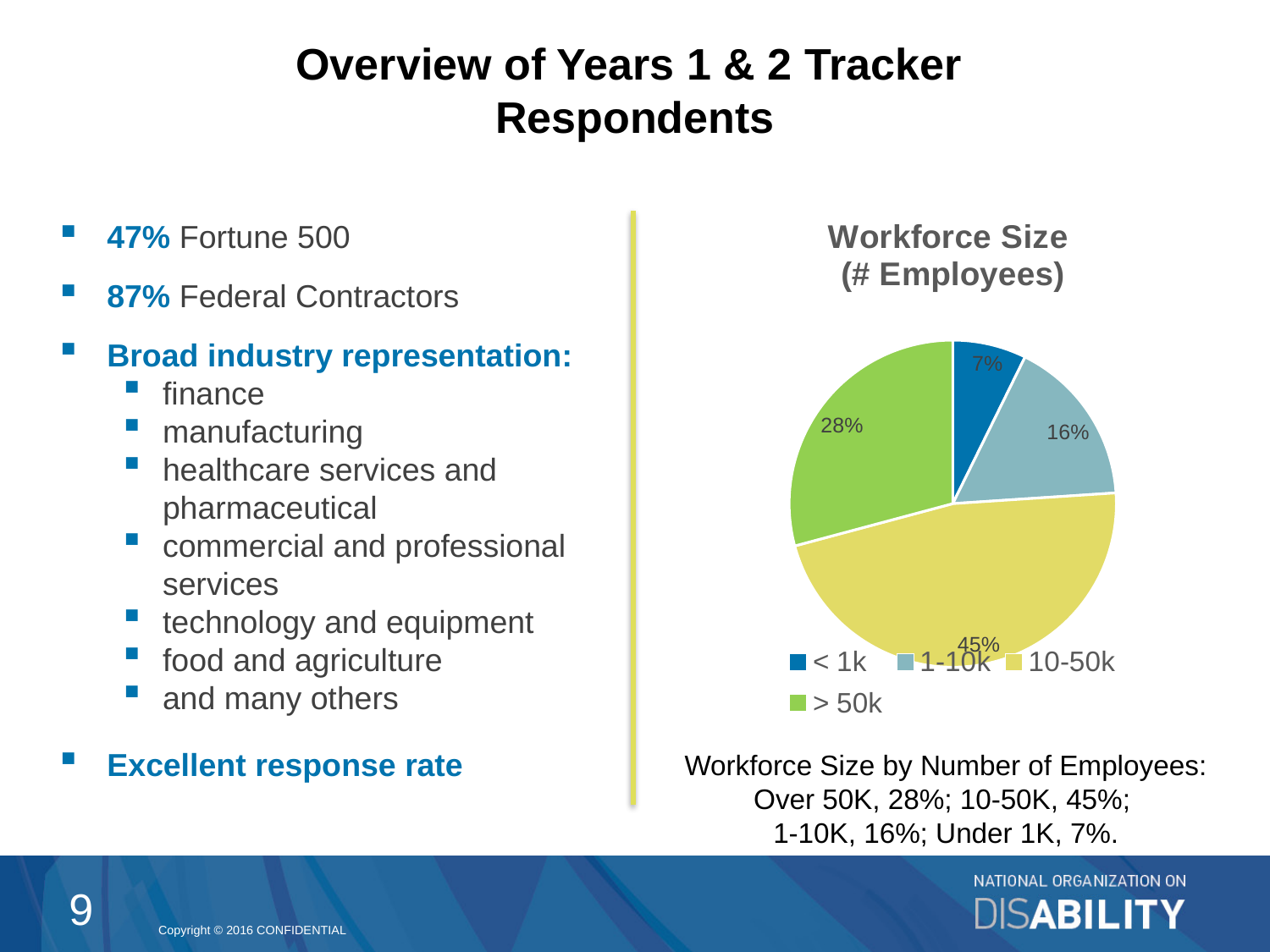
Which workforce size category has the largest share of the pie? 10-50k What share of respondents have a workforce of < 1k employees? 7% What is the difference in percentage points between the 10-50k and > 50k slices? 17 Which is larger, the share for 1-10k or the share for > 50k? > 50k What is the title of the chart? Workforce Size (# Employees) What share of respondents have a workforce of > 50k employees? 28% What colour is the slice for 10-50k employees? yellow What kind of chart is shown on the slide? pie chart What share of respondents have a workforce of 1-10k employees? 16% What share of respondents have a workforce of 10-50k employees? 45% How many categories does the legend list? 4 Which workforce size category has the smallest share of the pie? < 1k